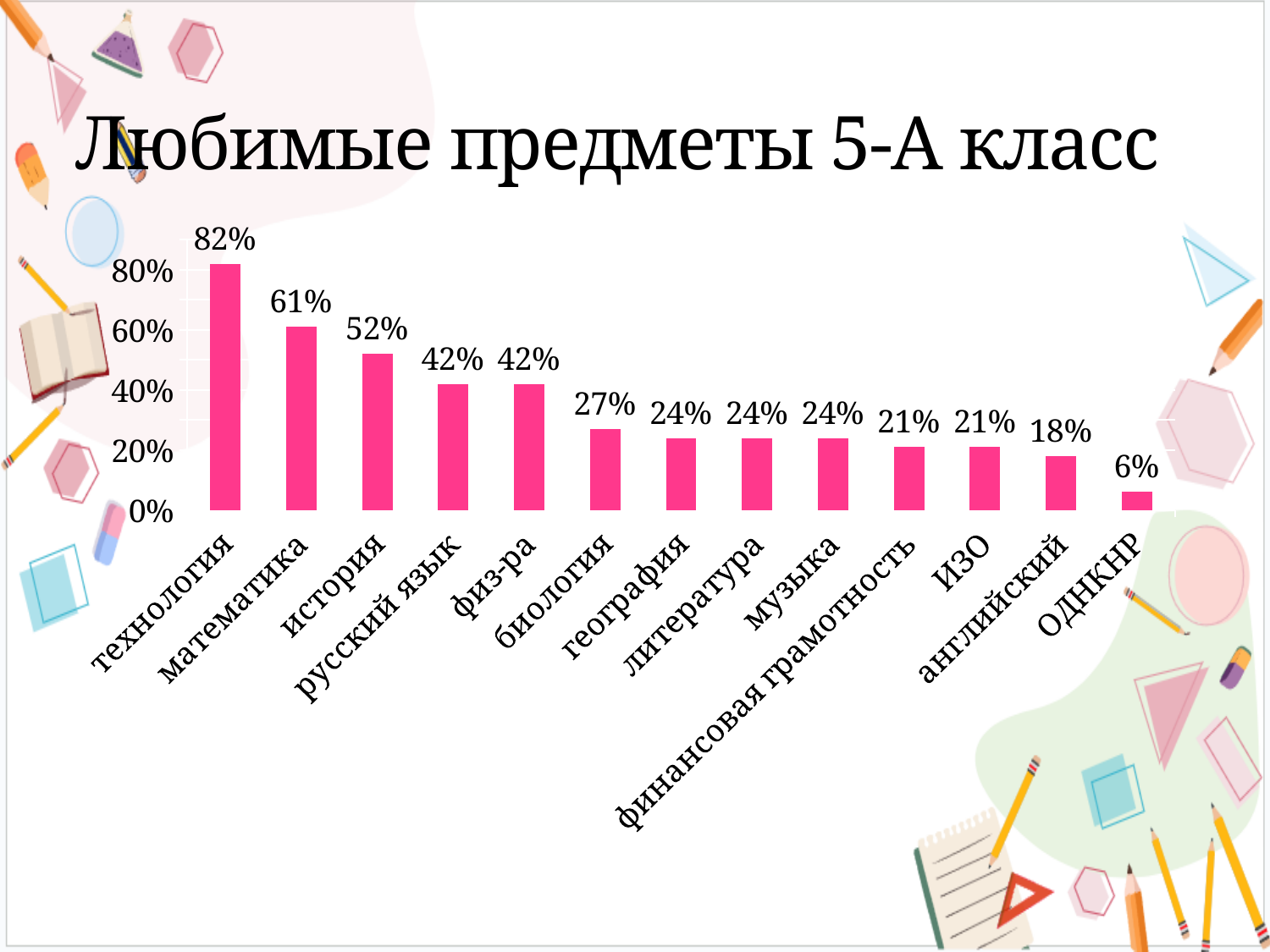
What is the value for английский? 18% Is the value for русский язык greater or less than 40%? greater What is the title of the slide? Любимые предметы 5-А класс What is the value for технология? 82% What is the value for финансовая грамотность? 21% Which subject has the highest value? технология Do the values rise or fall from left to right along the x axis? fall Which subject has the lowest value? ОДНКНР What kind of chart is shown on the slide? bar chart Which is larger, the value for биология or the value for география? биология How many subjects are shown on the chart? 13 What is the difference between the values for математика and история? 9%